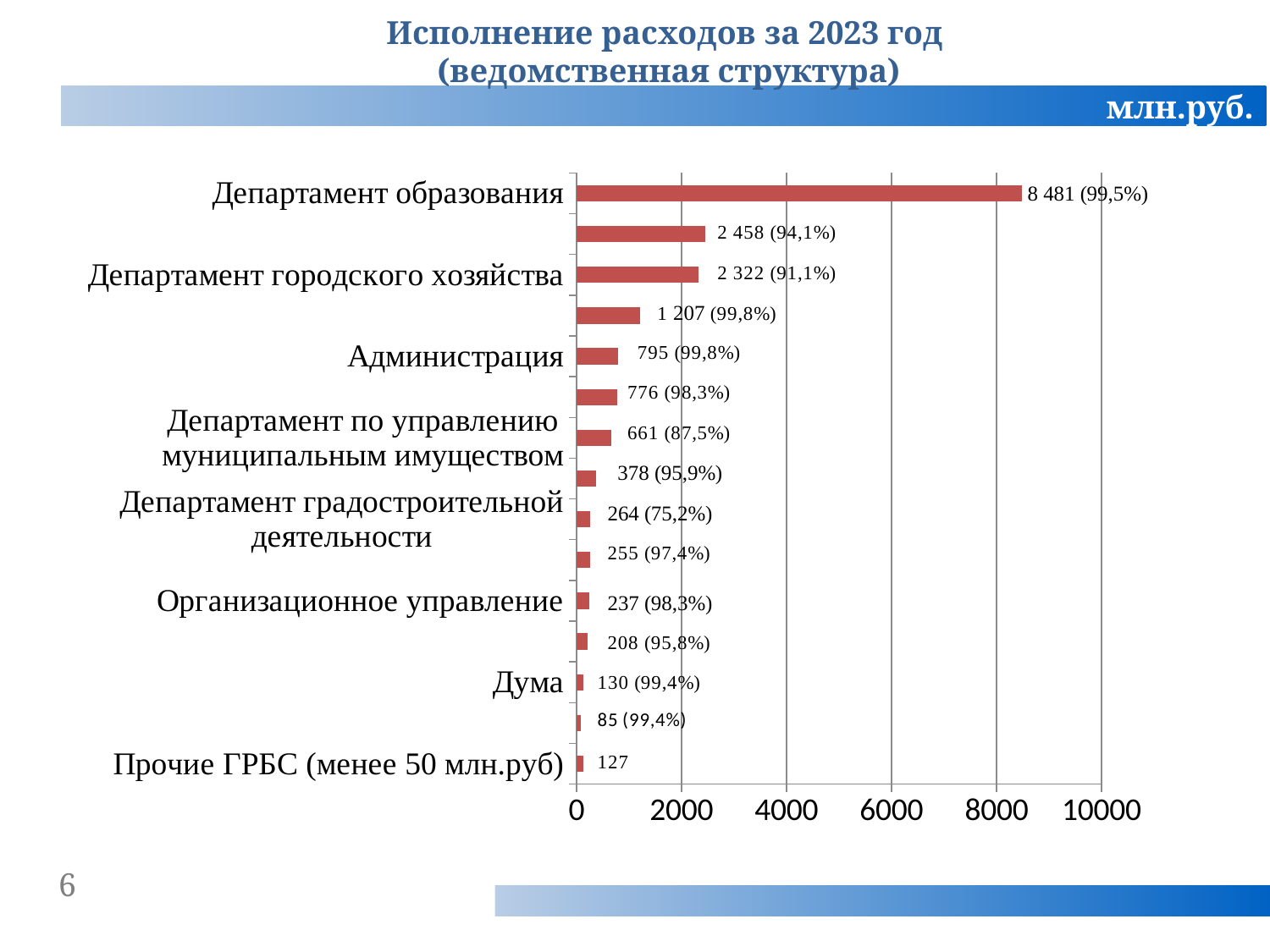
What is the value shown for Департамент образования? 8 481 (99,5%) What is the difference between the values for Администрация (795) and Дума (130)? 665 What unit of measurement is indicated for the chart values? млн.руб. What is the value shown for Прочие ГРБС (менее 50 млн.руб)? 127 What is the value shown for Департамент городского хозяйства? 2 322 (91,1%) Is the value for Департамент городского хозяйства greater or less than 2000? greater What kind of chart is shown on the slide? bar chart What is the value shown for Департамент по управлению муниципальным имуществом? 661 (87,5%) What is the value shown for Администрация? 795 (99,8%) Which is larger, the value for Администрация or the value for Организационное управление? Администрация What is the value shown for Дума? 130 (99,4%) Which category has the highest value? Департамент образования